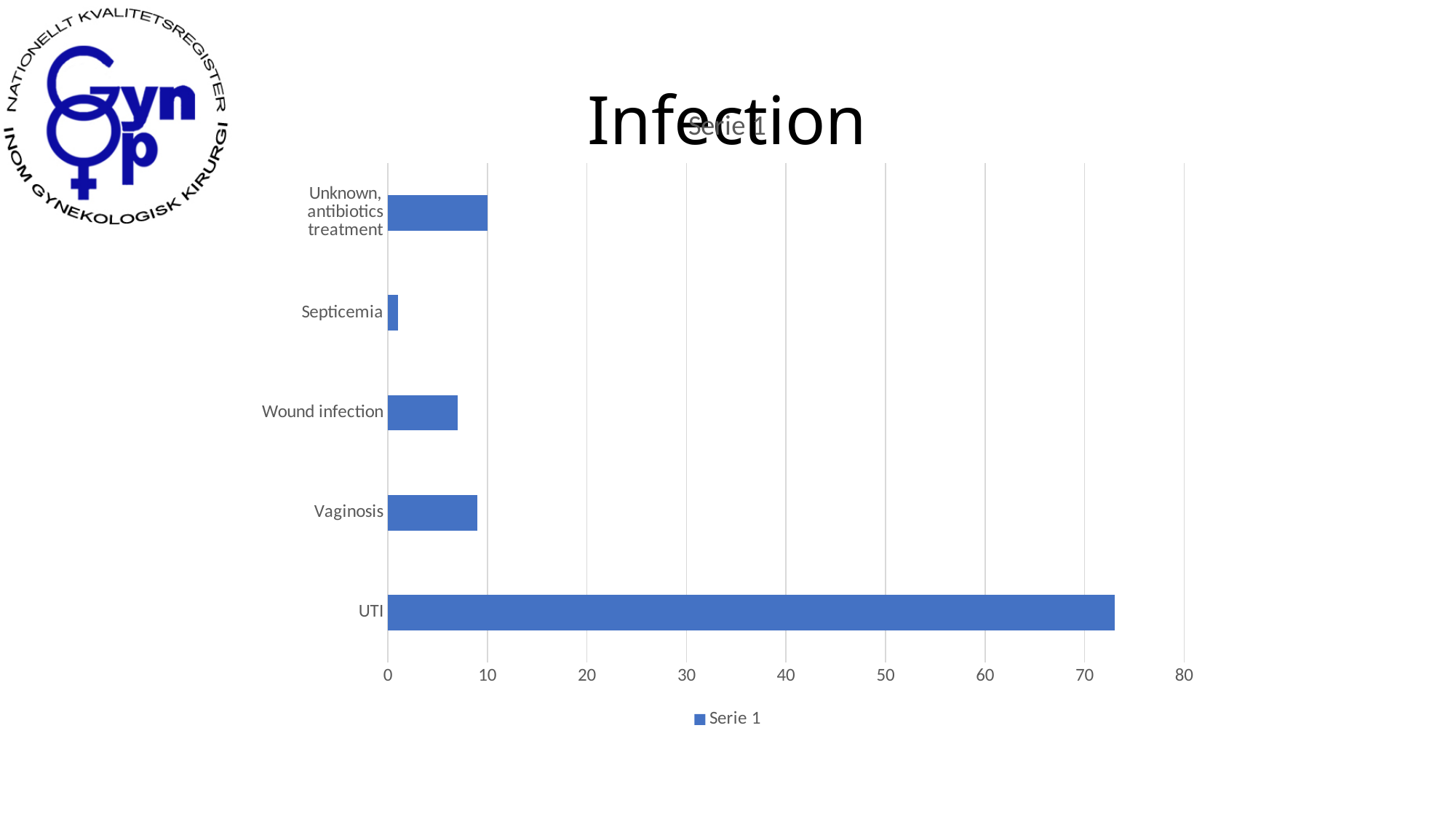
Which category has the highest value? UTI Which is larger, the value for Unknown, antibiotics treatment or the value for Septicemia? Unknown, antibiotics treatment Is the value for Septicemia greater or less than 10? less What is the name of the series shown in the legend? Serie 1 How many series does the legend list? 1 Is the value for Wound infection greater or less than 10? less Which is larger, the value for UTI or the value for Vaginosis? UTI What kind of chart is shown on the slide? bar chart Which category has the lowest value? Septicemia Is the value for UTI greater or less than 70? greater What is the title of the slide? Infection How many categories are plotted in the chart? 5